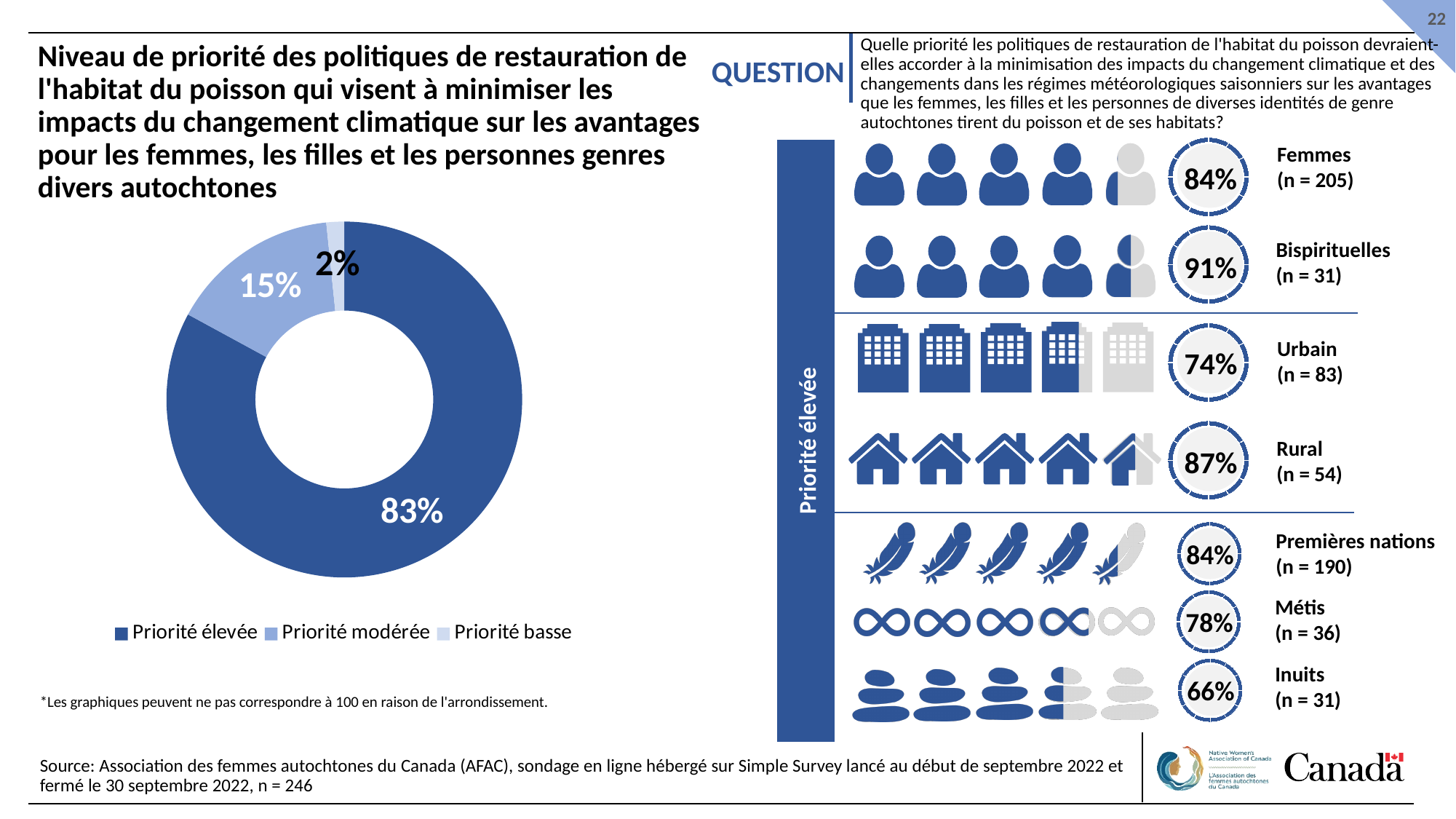
In the donut chart on the left, what percentage is shown for Priorité basse? 2% How many categories does the legend of the donut chart on the left list? 3 In the donut chart on the left, what percentage is shown for Priorité modérée? 15% In the donut chart on the left, what is the difference in percentage points between Priorité élevée and Priorité modérée? 68 In the infographic on the right, what is the sample size (n) shown for Urbain? n = 83 In the infographic on the right, what percentage is shown for Bispirituelles? 91% In the donut chart on the left, what percentage is shown for Priorité élevée? 83% What type of chart is shown on the left of the slide? Donut (pie) chart In the donut chart on the left, which category has the largest share? Priorité élevée In the donut chart on the left, which category has the smallest share? Priorité basse In the infographic on the right, which group has the lowest percentage? Inuits In the donut chart on the left, which is larger: Priorité modérée or Priorité basse? Priorité modérée